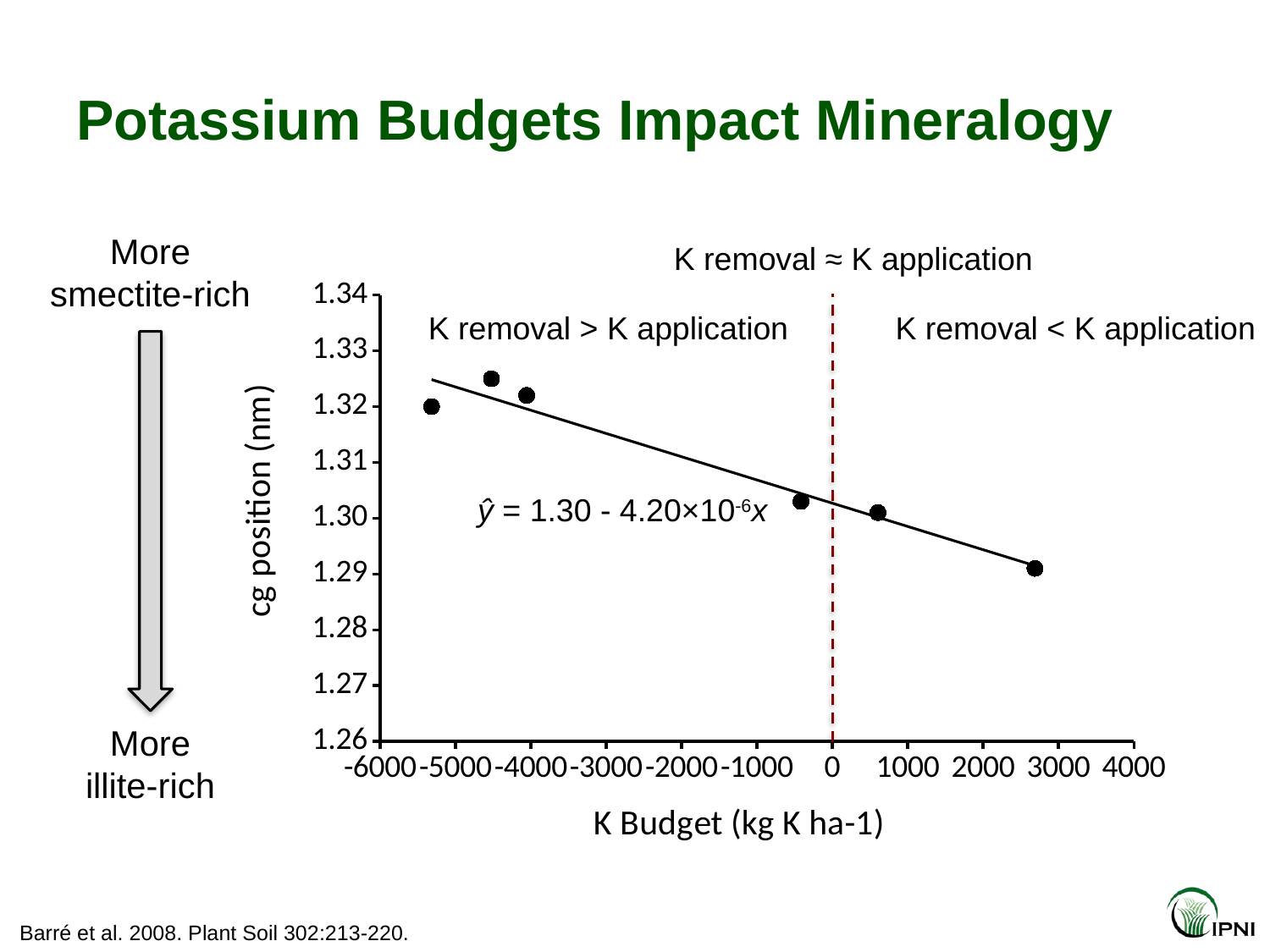
What kind of chart is shown on the slide? Scatter plot with a trend line What is the label of the x axis? K Budget (kg K ha-1) How many data points lie to the right of the dashed line at K budget = 0? 2 Is the cg position of the point with the lowest K budget (around -5300 kg K ha-1) greater or less than 1.31 nm? greater How many data points lie to the left of the dashed line at K budget = 0? 4 Is the cg position of the point with the highest K budget (around 2700 kg K ha-1) greater or less than 1.30 nm? less Which has the higher cg position: the point at a K budget of about -5300 or the point at a K budget of about 2700? The point at about -5300 Does cg position rise or fall as K budget increases along the x axis? Fall How many data points are plotted on the chart? 6 What regression equation is printed on the chart? ŷ = 1.30 - 4.20×10^-6 x Which plotted point has the lowest cg position? The point with the highest K budget (rightmost point)